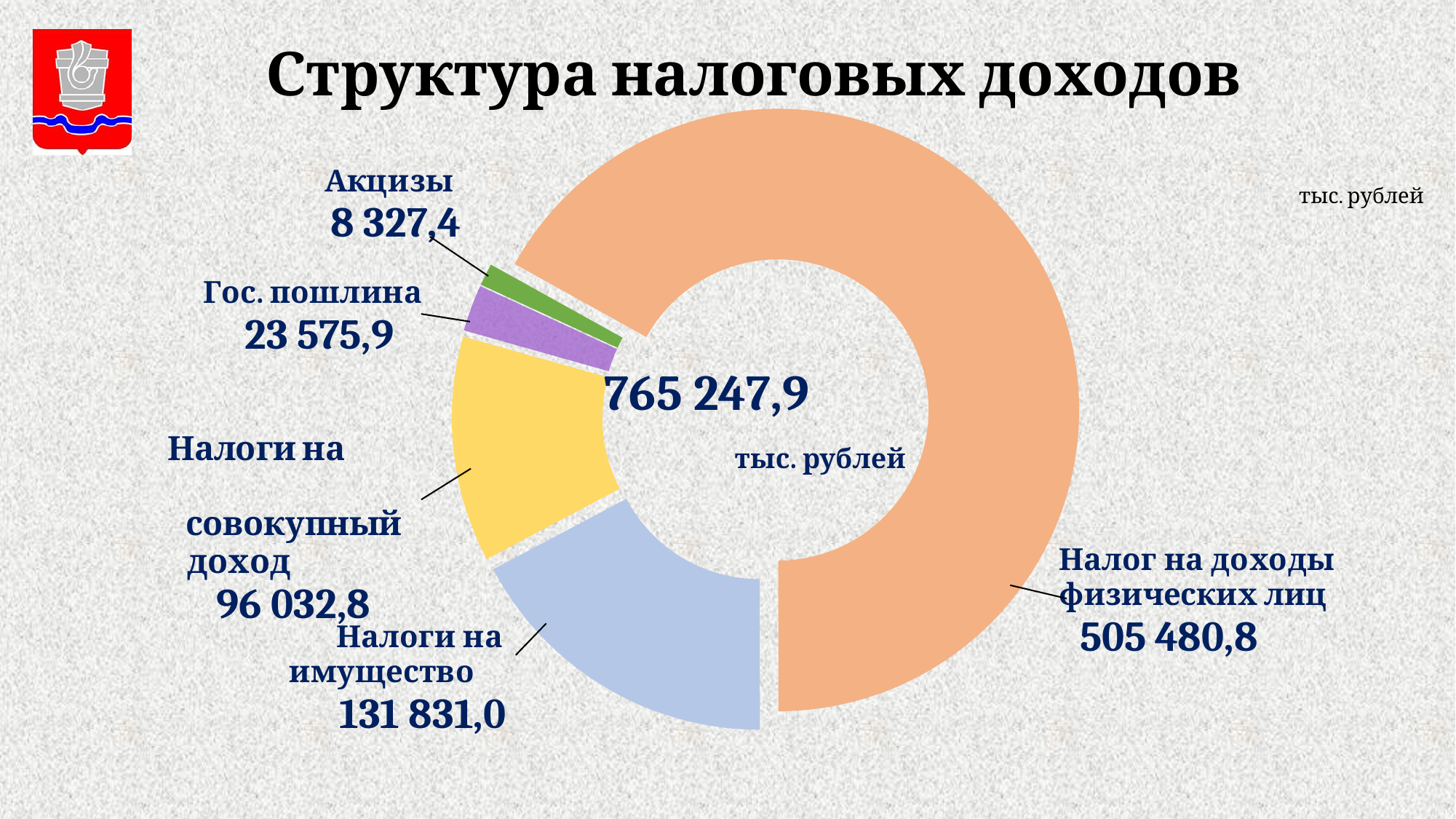
What is the total shown in the centre of the chart? 765 247,9 What is the value for Налоги на имущество? 131 831,0 What kind of chart is shown on the slide? doughnut chart What is the difference between Налоги на имущество and Налоги на совокупный доход? 35 798,2 What is the value for Акцизы? 8 327,4 What is the title of the chart? Структура налоговых доходов What is the value for Налог на доходы физических лиц? 505 480,8 How many categories are shown in the chart? 5 Which is larger: Гос. пошлина or Акцизы? Гос. пошлина Which category has the largest value? Налог на доходы физических лиц Which category has the smallest value? Акцизы What is the value for Гос. пошлина? 23 575,9